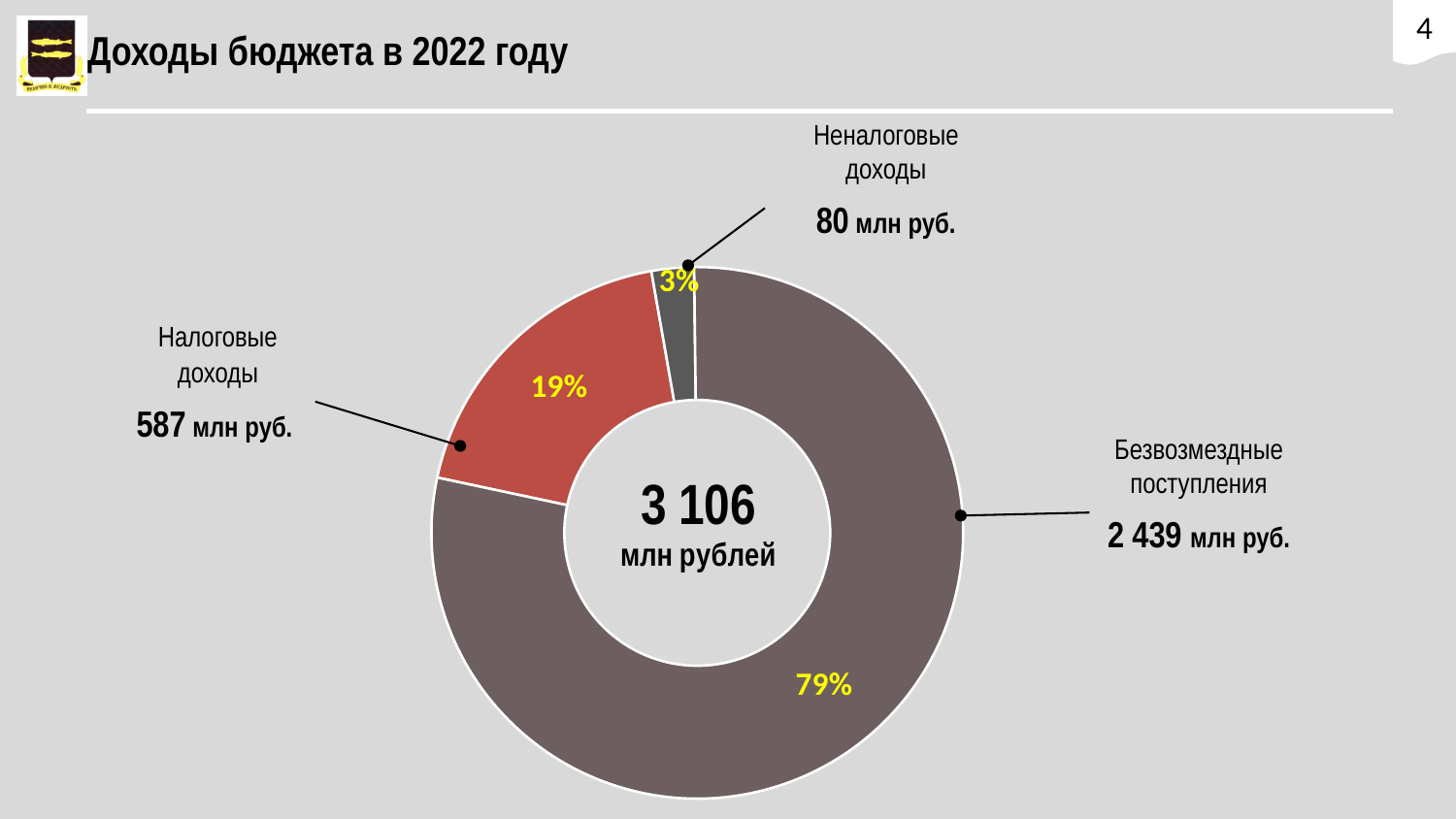
How many categories are shown in the chart? 3 What total value is shown in the centre of the chart? 3 106 млн рублей Which category has the largest share of the chart? Безвозмездные поступления What is the difference between Безвозмездные поступления and Налоговые доходы in млн руб.? 1 852 What percentage share does Неналоговые доходы have? 3% What is the value shown for Налоговые доходы? 587 млн руб. What is the value shown for Неналоговые доходы? 80 млн руб. What percentage share does Безвозмездные поступления have? 79% Which category has the smallest share of the chart? Неналоговые доходы What percentage share does Налоговые доходы have? 19% What is the value shown for Безвозмездные поступления? 2 439 млн руб. Which is larger: Налоговые доходы or Неналоговые доходы? Налоговые доходы